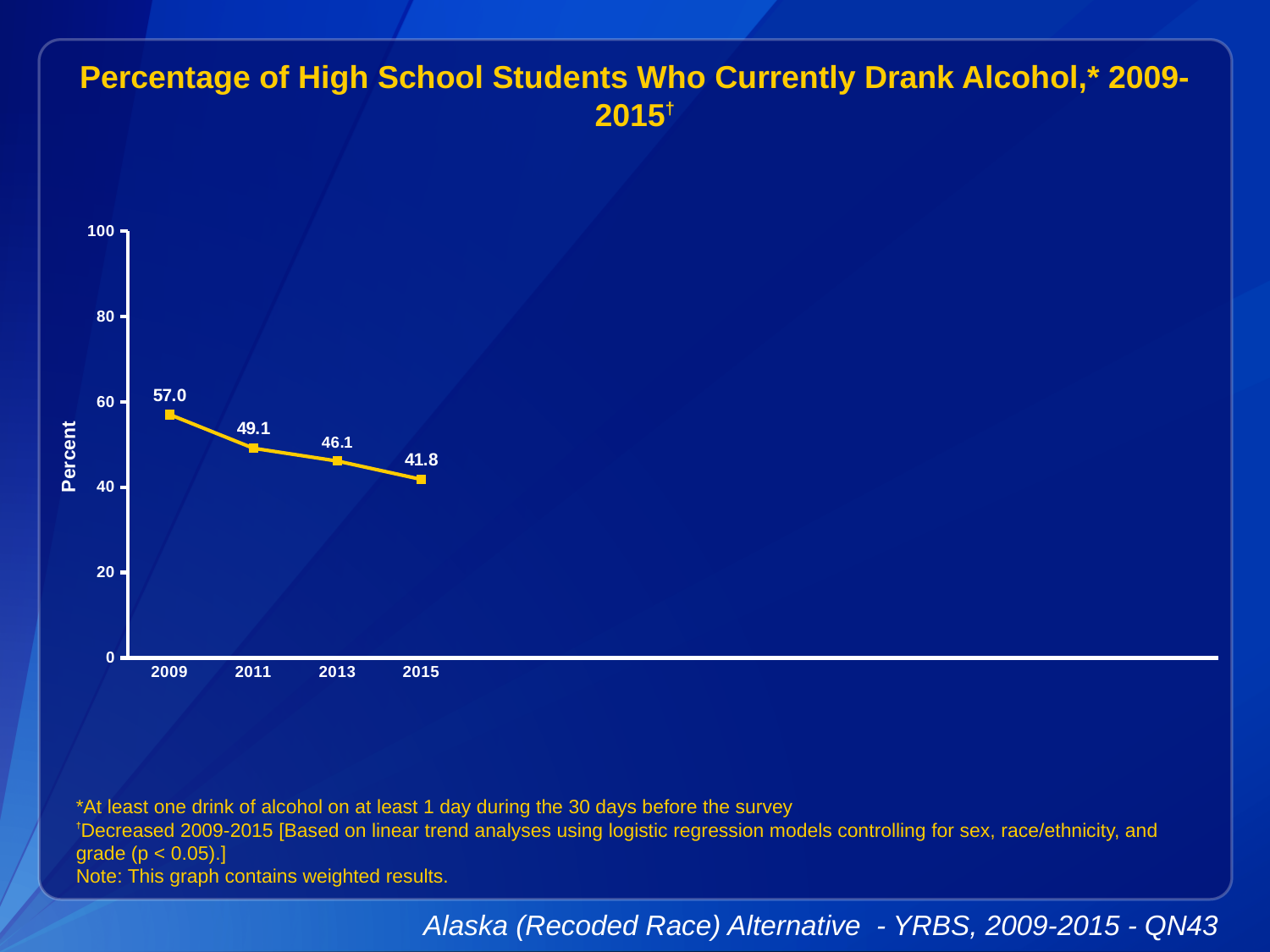
Which year has the lowest percentage? 2015 What is the value plotted for 2013? 46.1 What percentage of high school students currently drank alcohol in 2009? 57.0 What is the value plotted for 2015? 41.8 Which is larger, the value for 2011 or the value for 2013? 2011 How many years are plotted on the chart? 4 Which year has the highest percentage? 2009 What is the difference between the 2009 value and the 2015 value? 15.2 Do the values rise or fall from 2009 to 2015? fall What kind of chart is shown on the slide? line chart What is the label on the vertical axis? Percent Is the value for 2011 greater or less than 40? greater